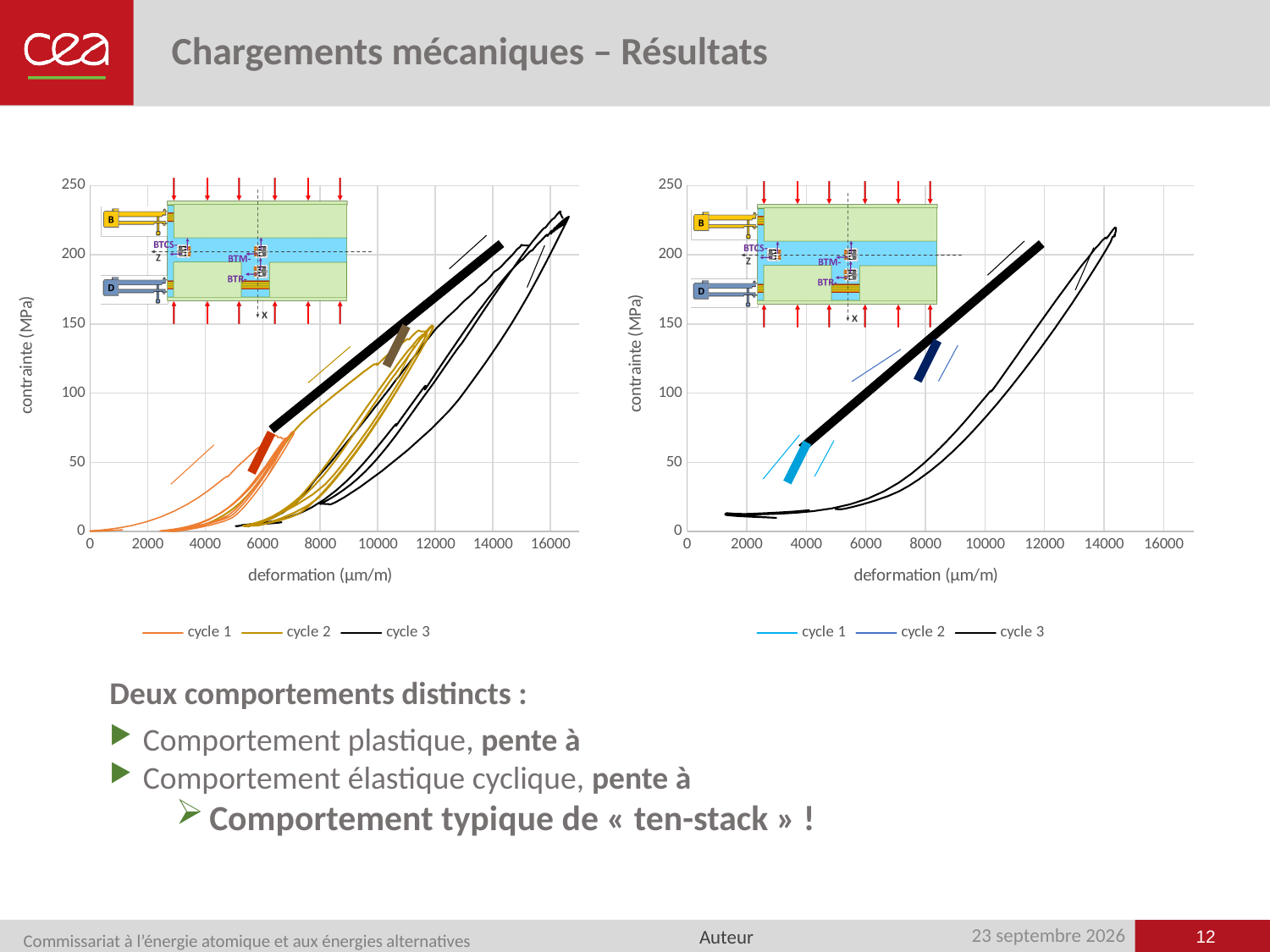
What is the label of the y axis of the right chart? contrainte (MPa) In the left chart, is the peak stress reached by cycle 1 greater or less than 100? less In the left chart, is the peak stress reached by cycle 3 greater or less than 200? greater How many series does the legend of the left chart list? 3 How many series does the legend of the right chart list? 3 In the left chart, which cycle reaches the highest stress (contrainte)? cycle 3 In the left chart, which cycle reaches the lowest peak stress? cycle 1 What is the label of the x axis of the left chart? deformation (µm/m) In the right chart, which cycle reaches the highest stress? cycle 3 What kind of chart is the left chart? line chart